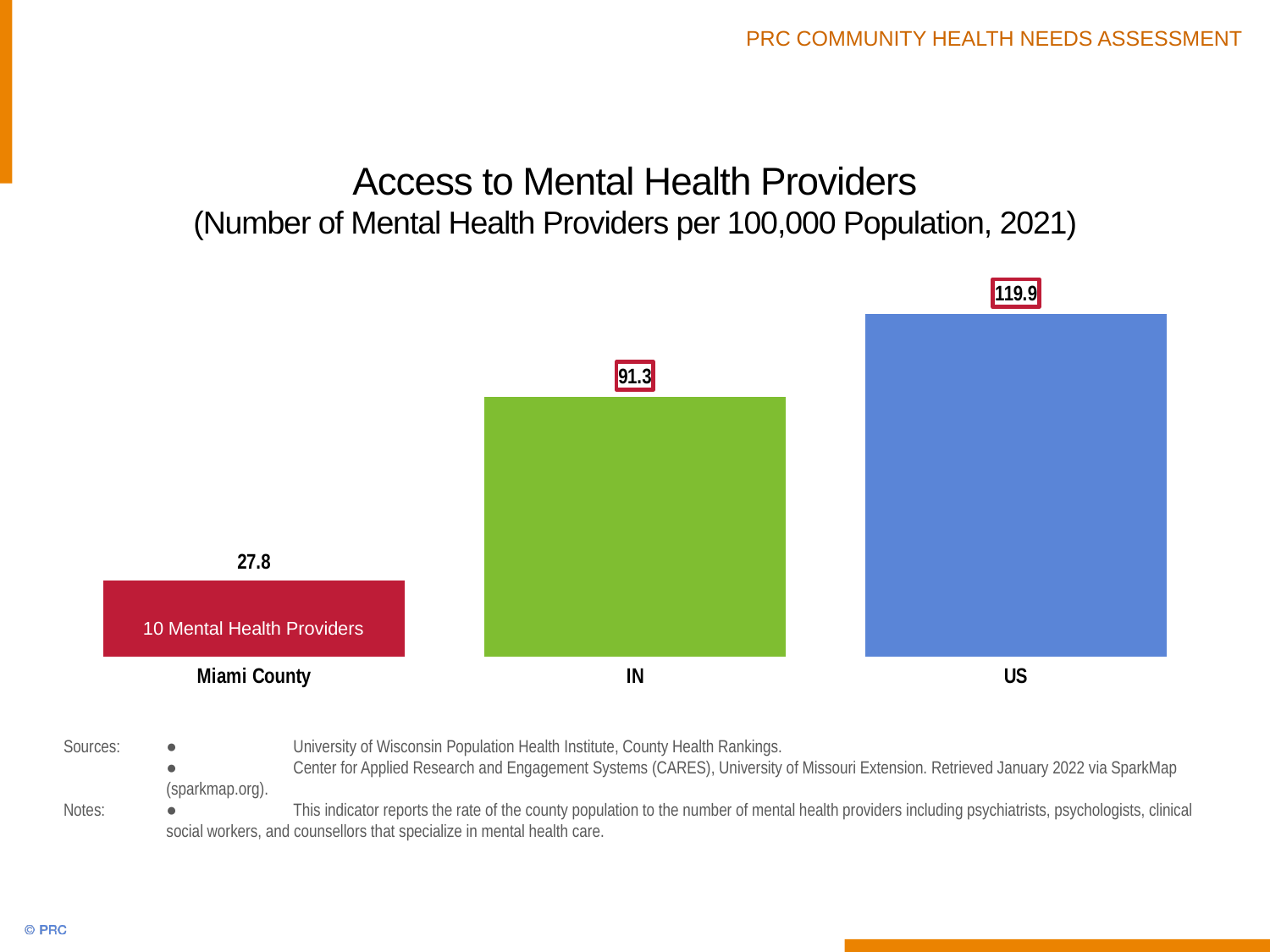
What is the value for Miami County? 27.8 Which category has the lowest value? Miami County What is the value for US? 119.9 What is the difference between the US value and the Miami County value? 92.1 What text is printed inside the Miami County bar? 10 Mental Health Providers Which category has the highest value? US What is the value for IN? 91.3 How many categories are shown in the chart? 3 What kind of chart is shown on the slide? Bar chart Which is larger, the value for IN or the value for US? US Do the values rise or fall from Miami County to US along the x axis? Rise What is the difference between the IN value and the Miami County value? 63.5